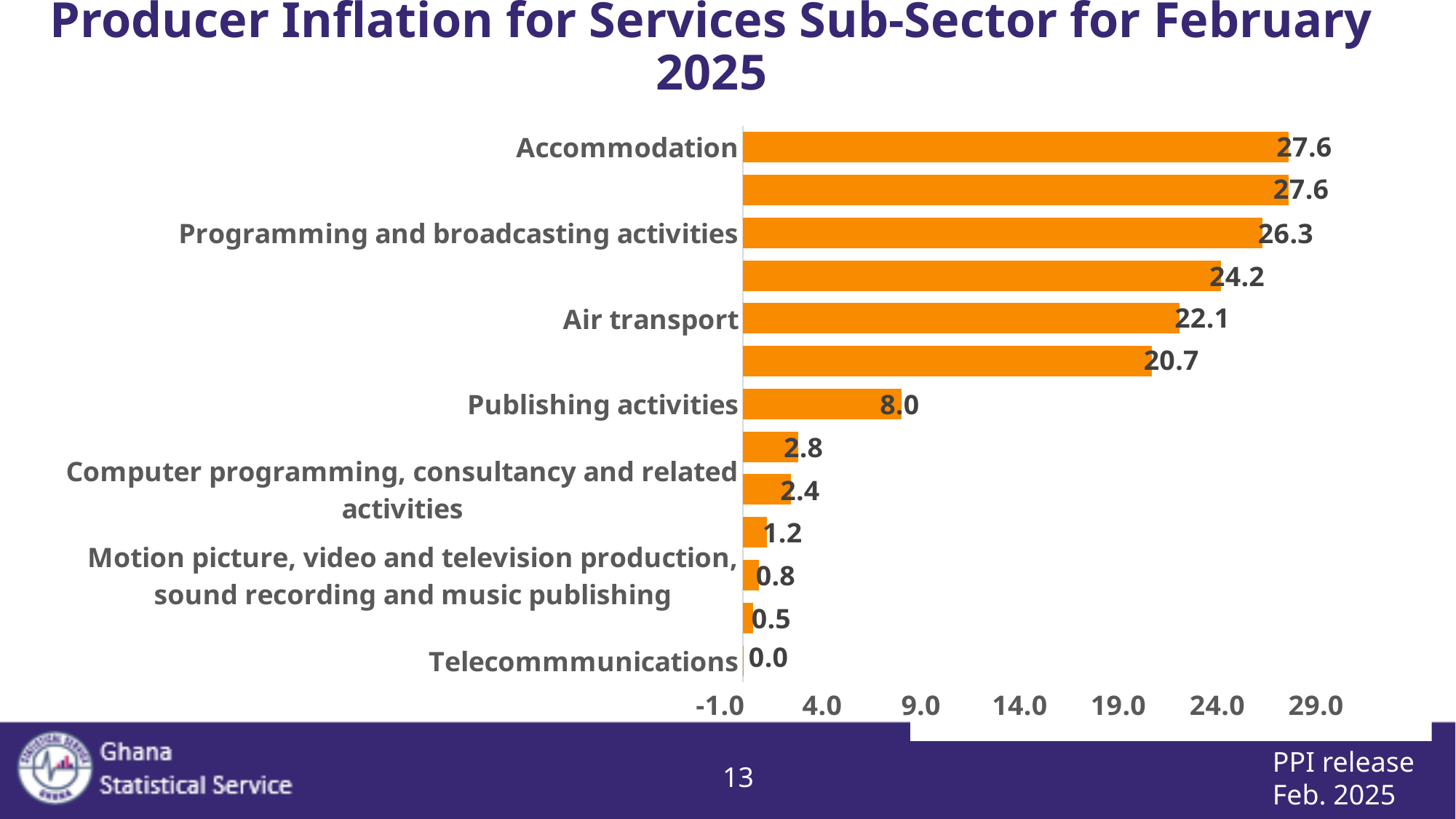
What is the value shown for Air transport? 22.1 What is the value shown for Programming and broadcasting activities? 26.3 How many bars are plotted in the chart? 13 What colour are the bars in the chart? Orange What is the producer inflation value for Accommodation? 27.6 Which labelled category has the lowest value? Telecommmunications Which is larger, the value for Publishing activities or the value for Motion picture, video and television production, sound recording and music publishing? Publishing activities What is the value shown for Telecommmunications? 0.0 What is the value shown for Publishing activities? 8.0 What is the value shown for Computer programming, consultancy and related activities? 2.4 What is the difference between the values for Accommodation and Air transport? 5.5 What kind of chart is shown on the slide? Bar chart